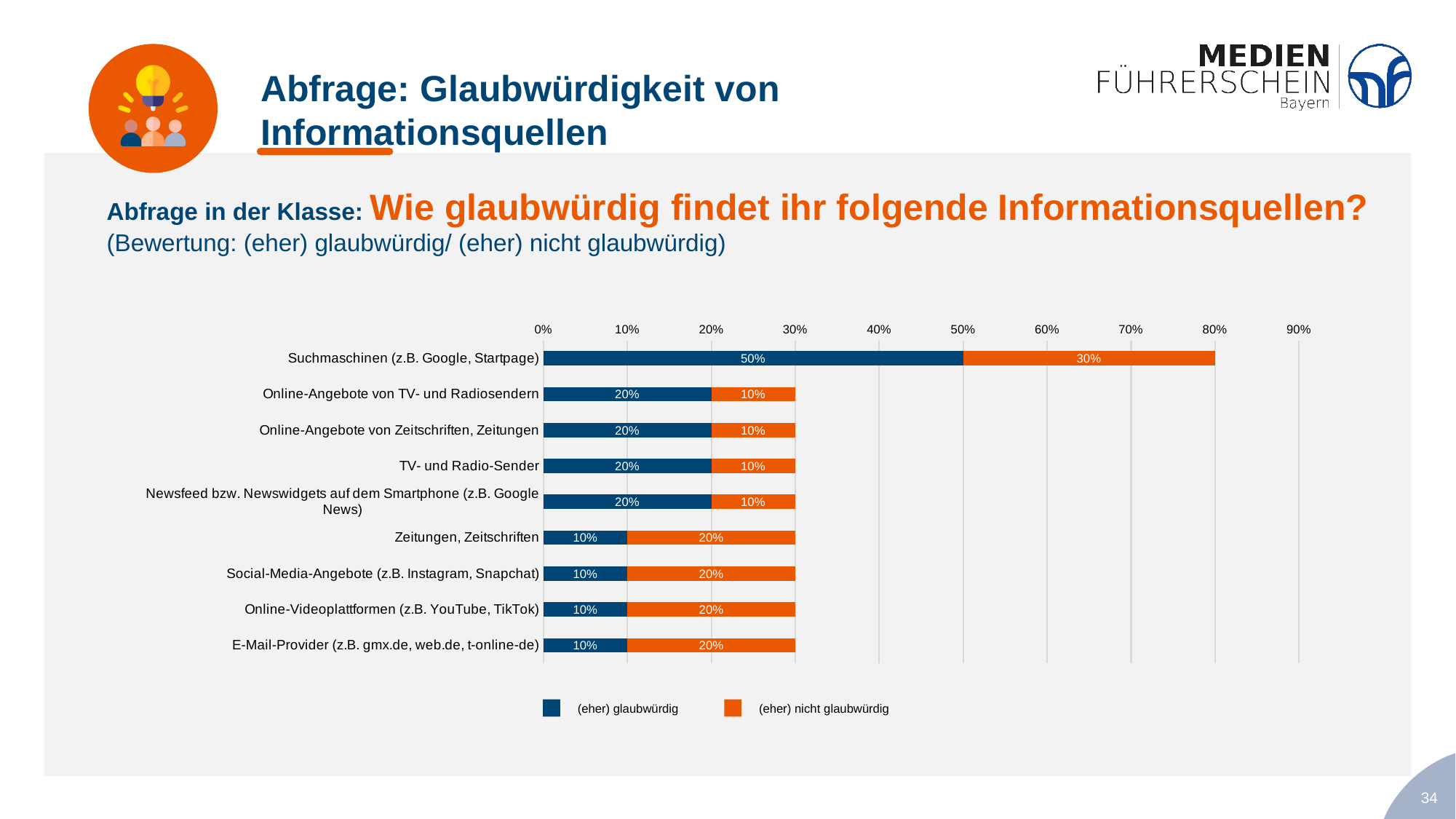
What is the difference between the "(eher) glaubwürdig" and "(eher) nicht glaubwürdig" values for Suchmaschinen (z.B. Google, Startpage)? 20% What kind of chart is shown on the slide? Stacked bar chart What is the value of "(eher) glaubwürdig" for Zeitungen, Zeitschriften? 10% How many categories are shown in the chart? 9 What is the value of "(eher) nicht glaubwürdig" for Suchmaschinen (z.B. Google, Startpage)? 30% What is the total of the stacked bar for TV- und Radio-Sender? 30% How many series does the legend list? 2 For Social-Media-Angebote (z.B. Instagram, Snapchat), which is larger: "(eher) glaubwürdig" or "(eher) nicht glaubwürdig"? (eher) nicht glaubwürdig What is the value of "(eher) glaubwürdig" for Suchmaschinen (z.B. Google, Startpage)? 50% What is the value of "(eher) nicht glaubwürdig" for Online-Videoplattformen (z.B. YouTube, TikTok)? 20% What is the total of the stacked bar for Suchmaschinen (z.B. Google, Startpage)? 80% Which category has the highest "(eher) glaubwürdig" value? Suchmaschinen (z.B. Google, Startpage)